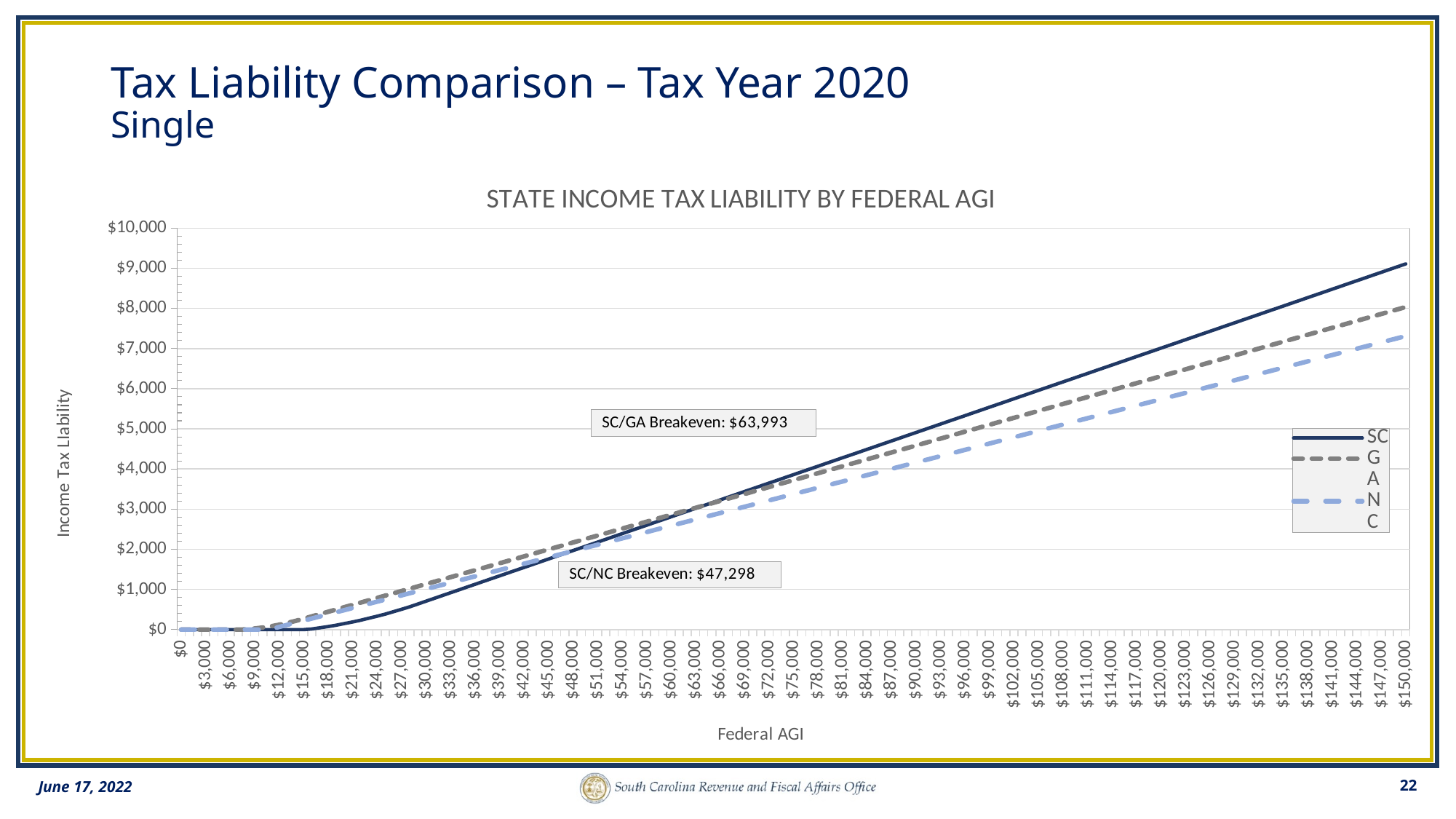
Does the SC income tax liability rise or fall as Federal AGI increases? Rises What is the title of the chart? STATE INCOME TAX LIABILITY BY FEDERAL AGI At a Federal AGI of $120,000, which series shows a higher income tax liability, SC or NC? SC How many series does the chart's legend list? 3 What kind of chart is shown on the slide? Line chart Which series has the lowest income tax liability at a Federal AGI of $150,000? NC At what Federal AGI does the chart mark the SC/NC breakeven? $47,298 At a Federal AGI of $30,000, which series shows a higher income tax liability, SC or GA? GA Which series are listed in the chart's legend? SC, GA, NC Which series has the highest income tax liability at a Federal AGI of $150,000? SC At what Federal AGI does the chart mark the SC/GA breakeven? $63,993 Is the SC income tax liability at a Federal AGI of $150,000 greater or less than $8,000? greater